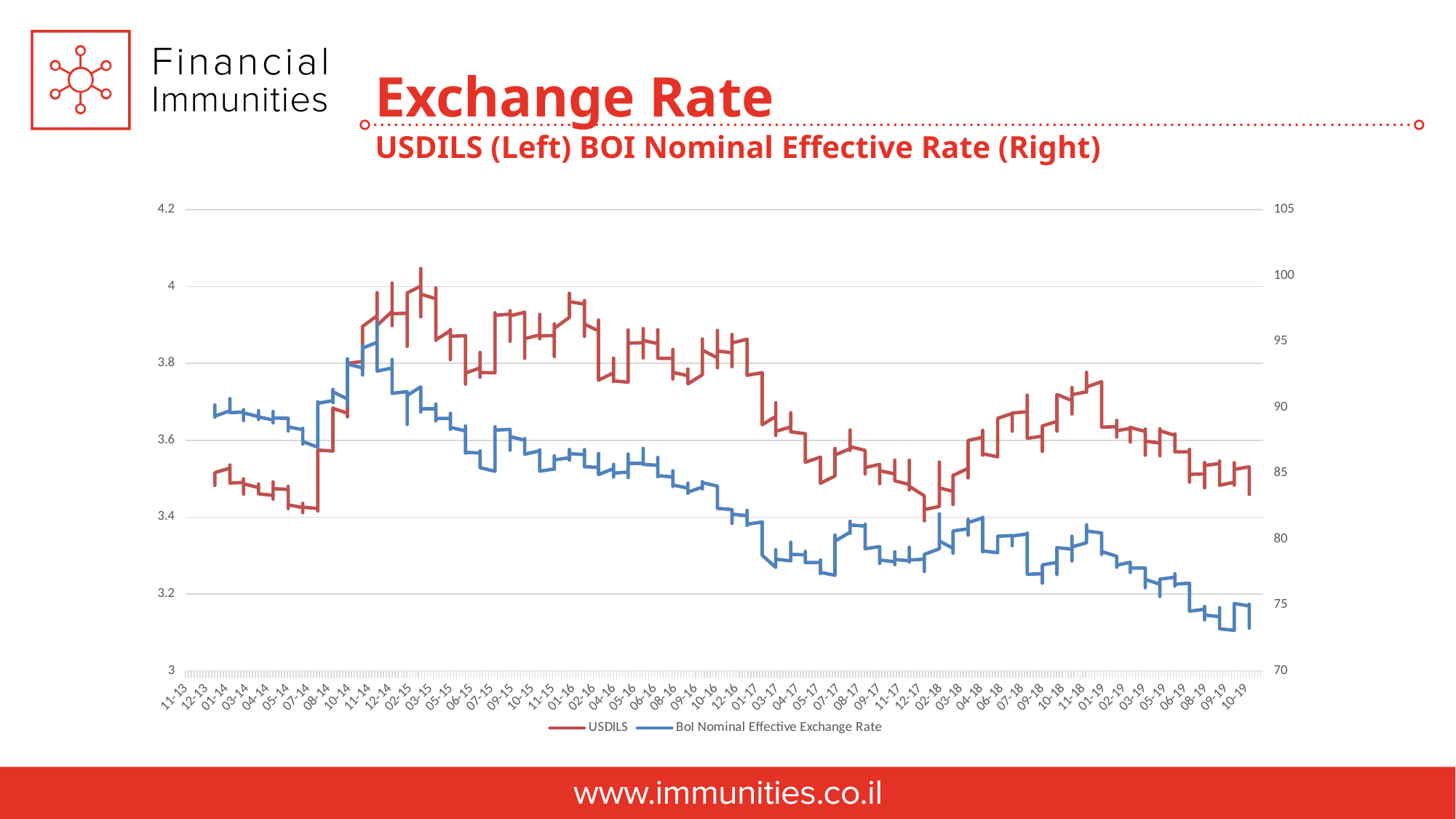
Is the BoI Nominal Effective Exchange Rate value at 10-19 greater or less than 75? less What colour is the USDILS line? red How many series does the legend list? 2 Is the USDILS value at 01-14 greater or less than 3.6? less Which is larger for USDILS: the value around 03-15 or the value around 02-18? 03-15 Is the BoI Nominal Effective Exchange Rate value at 01-14 greater or less than 85? greater What kind of chart is shown on the slide? line chart Does the BoI Nominal Effective Exchange Rate line rise or fall from 01-19 to 10-19? fall What are the two series named in the legend? USDILS and BoI Nominal Effective Exchange Rate Does the BoI Nominal Effective Exchange Rate line rise or fall overall from 01-14 to 10-19? fall